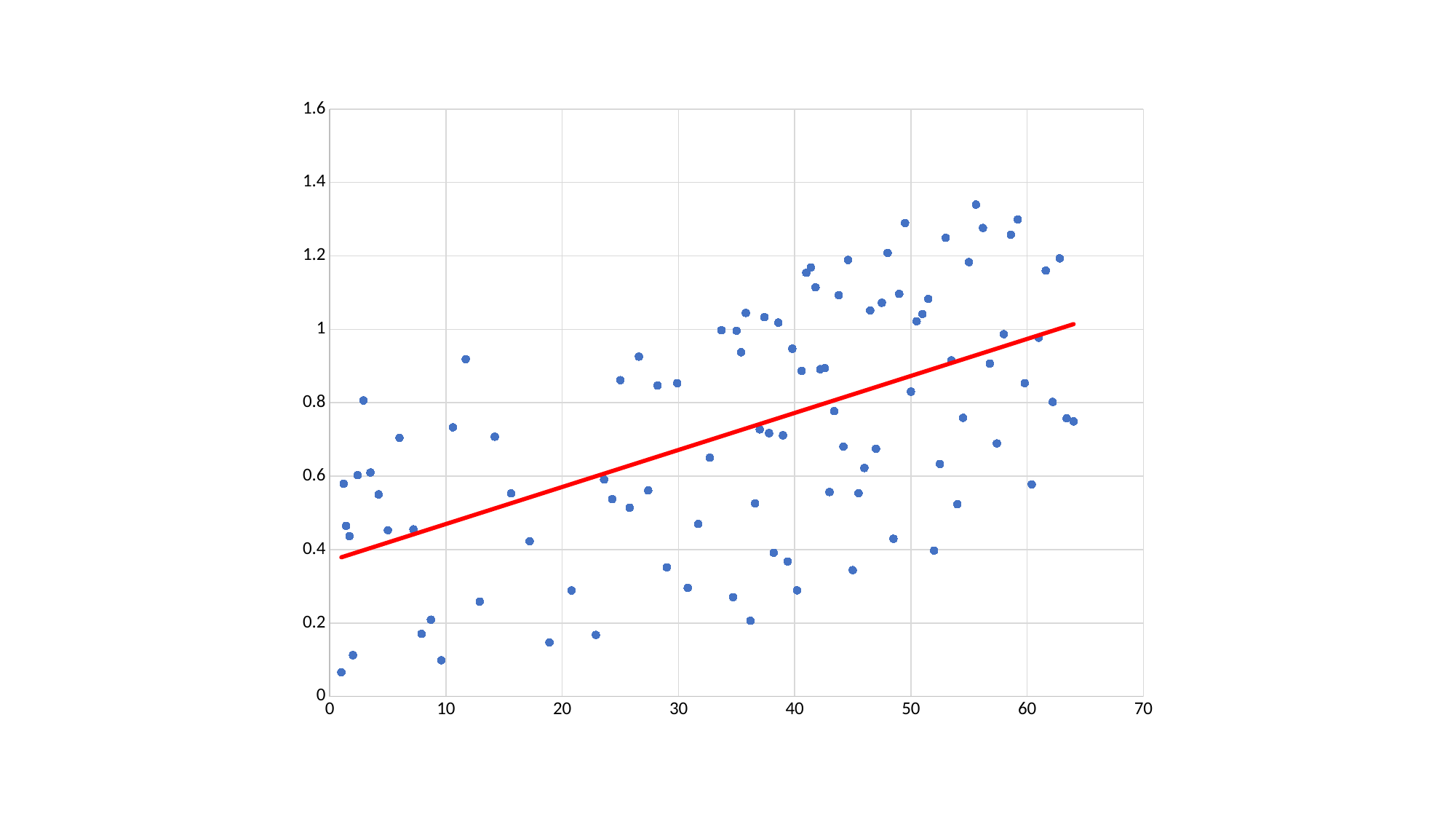
Are any plotted points above 1.4 on the y axis? no Is the value of the red trend line at x = 50 greater or less than 0.8? greater Is the value of the red trend line at x = 30 greater or less than 0.8? less What is the highest tick value shown on the x axis? 70 What colour is the trend line on the chart? red What kind of chart is shown on the slide? scatter chart Does the red trend line slope upward or downward from left to right? upward Do the plotted values generally rise or fall as the x-axis value increases? rise